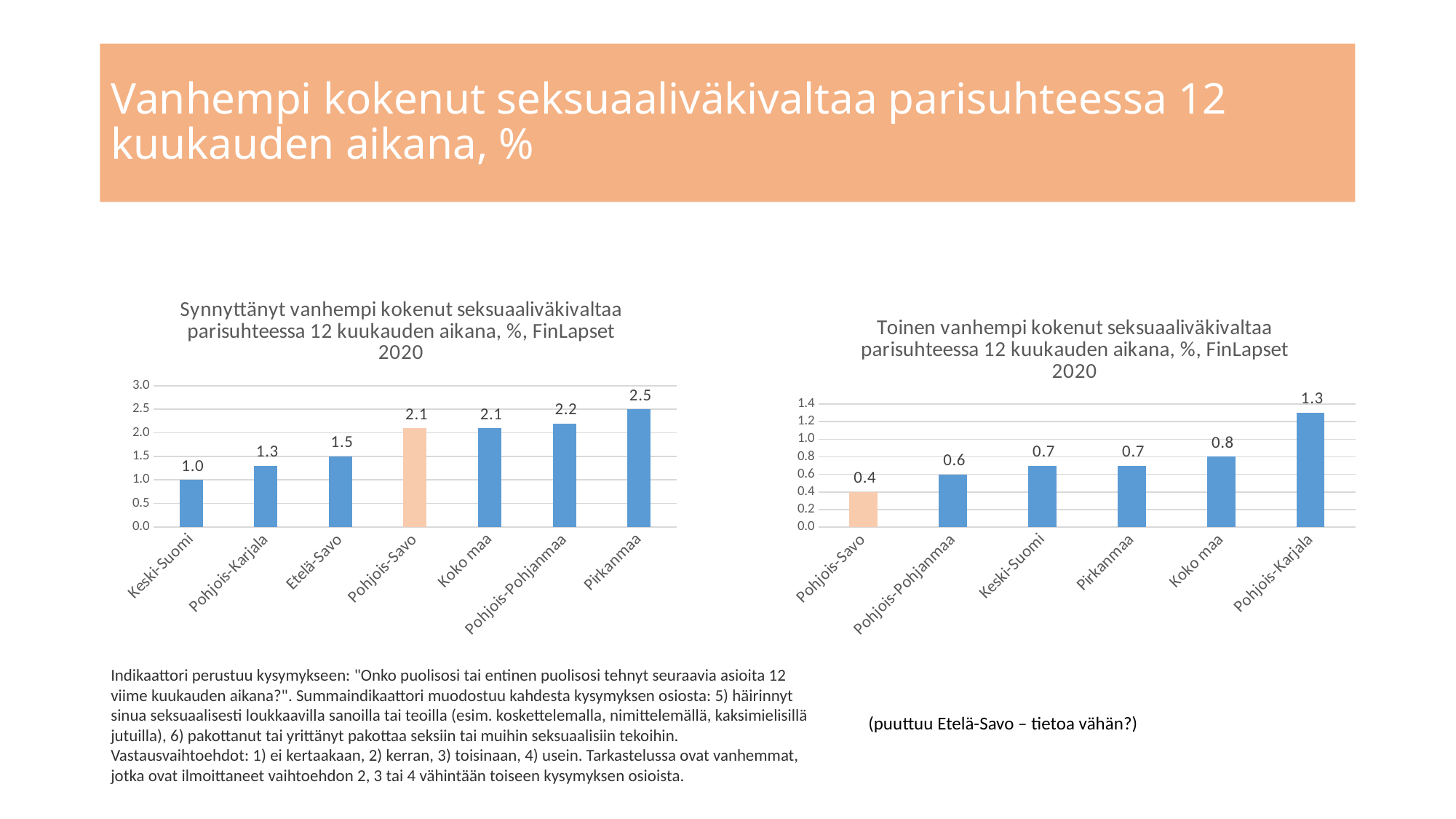
In the right chart (Toinen vanhempi), which category has the lowest value? Pohjois-Savo What type of chart is the right chart (Toinen vanhempi)? Bar chart In the left chart (Synnyttänyt vanhempi), what is the value for Pohjois-Savo? 2.1 In the left chart (Synnyttänyt vanhempi), which category has the lowest value? Keski-Suomi In the right chart (Toinen vanhempi), which category has the highest value? Pohjois-Karjala In the right chart (Toinen vanhempi), what is the value for Koko maa? 0.8 In the right chart (Toinen vanhempi), how many categories are shown? 6 In the left chart (Synnyttänyt vanhempi), how many categories are shown? 7 In the left chart (Synnyttänyt vanhempi), is the value for Etelä-Savo greater or less than 2.0? less In the left chart (Synnyttänyt vanhempi), what is the difference between Pirkanmaa and Keski-Suomi? 1.5 In the left chart (Synnyttänyt vanhempi), which category has the highest value? Pirkanmaa In the right chart (Toinen vanhempi), which is larger, Pohjois-Pohjanmaa or Koko maa? Koko maa